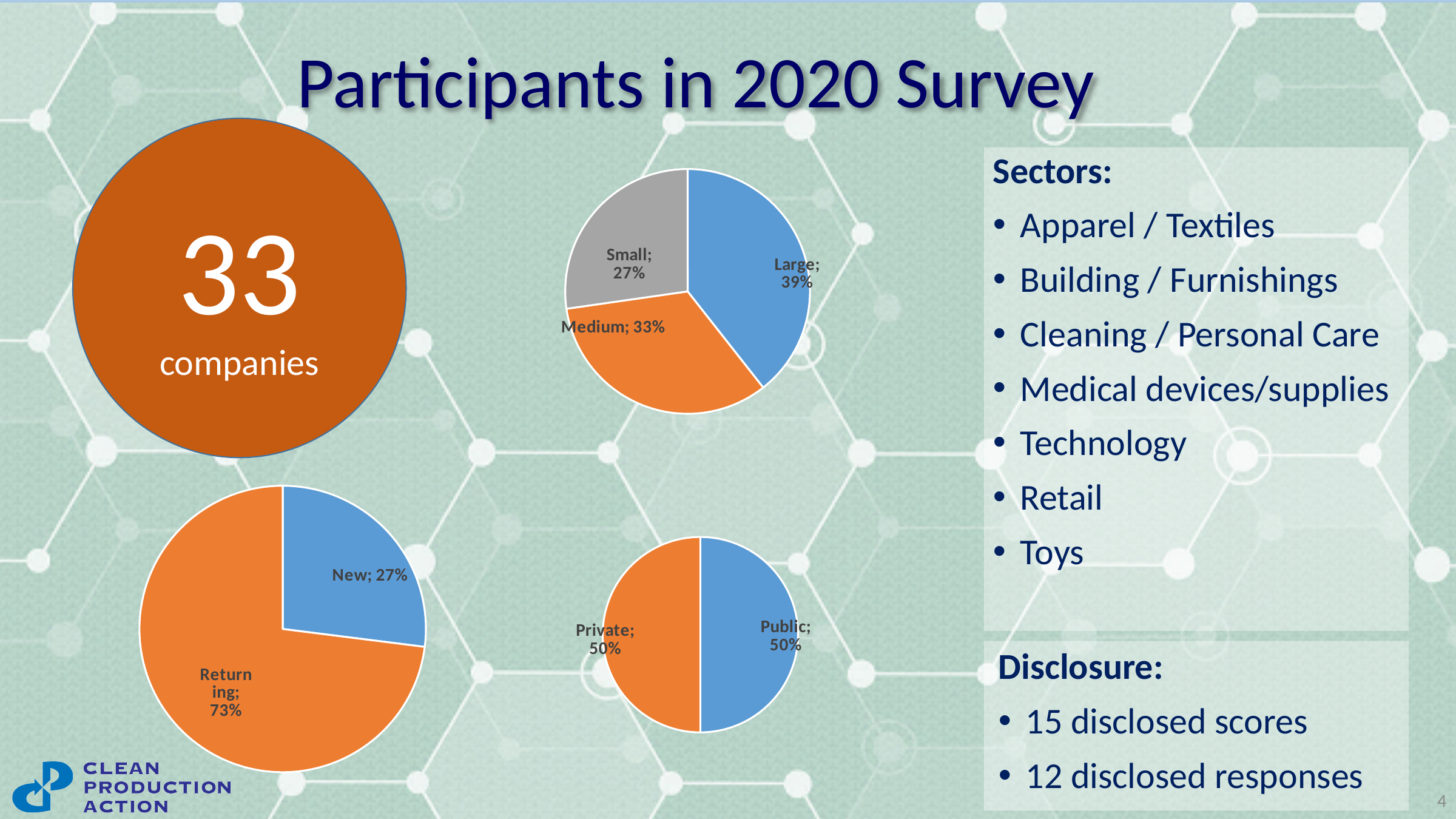
In the pie chart at the bottom left of the slide, what share is labelled Returning? 73% In the pie chart at the top centre of the slide, which category has the smallest share? Small What type of chart is used at the bottom centre of the slide? Pie chart In the pie chart at the top centre of the slide, what share is labelled Large? 39% In the pie chart at the top centre of the slide, which category has the largest share? Large In the pie chart at the bottom left of the slide, what share is labelled New? 27% In the pie chart at the top centre of the slide, what is the difference between the Large and Small shares? 12% In the pie chart at the top centre of the slide, how many slices are there? 3 In the pie chart at the top centre of the slide, what colour is the Small slice? Grey In the pie chart at the bottom centre of the slide, what share is labelled Private? 50% In the pie chart at the top centre of the slide, what share is labelled Medium? 33% In the pie chart at the bottom left of the slide, which is larger, New or Returning? Returning